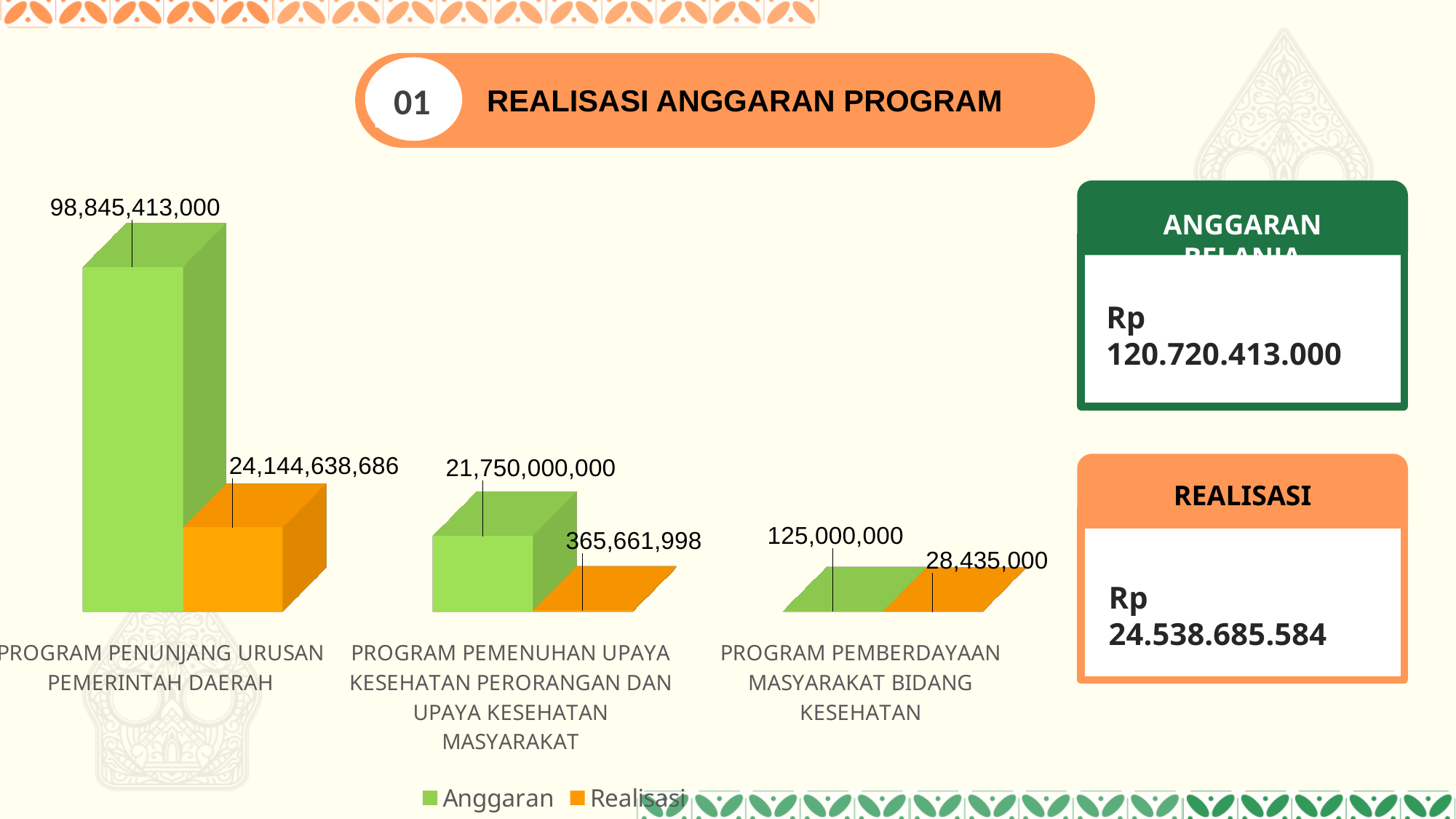
What is the Anggaran value for PROGRAM PEMENUHAN UPAYA KESEHATAN PERORANGAN DAN UPAYA KESEHATAN MASYARAKAT? 21,750,000,000 Which program has the highest Anggaran value? PROGRAM PENUNJANG URUSAN PEMERINTAH DAERAH What is the difference between the Anggaran and Realisasi values for PROGRAM PEMBERDAYAAN MASYARAKAT BIDANG KESEHATAN? 96,565,000 How many programs (categories) are shown in the chart? 3 Which is larger: the Realisasi value for PROGRAM PENUNJANG URUSAN PEMERINTAH DAERAH or the Anggaran value for PROGRAM PEMENUHAN UPAYA KESEHATAN PERORANGAN DAN UPAYA KESEHATAN MASYARAKAT? Realisasi for PROGRAM PENUNJANG URUSAN PEMERINTAH DAERAH What is the Anggaran value for PROGRAM PENUNJANG URUSAN PEMERINTAH DAERAH? 98,845,413,000 What is the Realisasi value for PROGRAM PENUNJANG URUSAN PEMERINTAH DAERAH? 24,144,638,686 What is the Realisasi value for PROGRAM PEMBERDAYAAN MASYARAKAT BIDANG KESEHATAN? 28,435,000 Which program has the lowest Realisasi value? PROGRAM PEMBERDAYAAN MASYARAKAT BIDANG KESEHATAN What is the difference between the Anggaran and Realisasi values for PROGRAM PENUNJANG URUSAN PEMERINTAH DAERAH? 74,700,774,314 How many series does the chart legend list? 2 What type of chart is shown on the slide? Bar chart